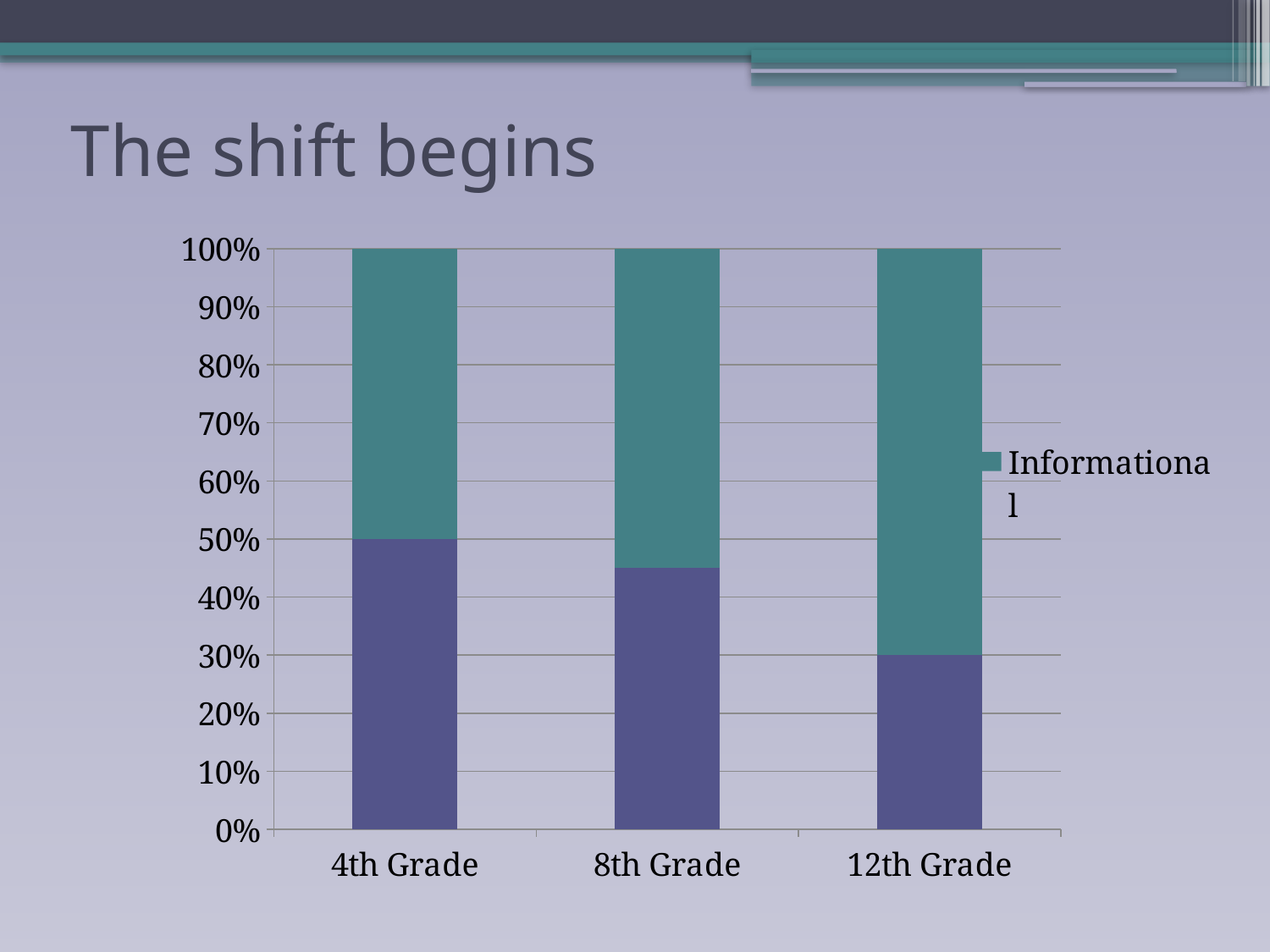
Which grade has the largest Informational (teal) share? 12th Grade What kind of chart is shown on the slide? stacked bar chart Is the purple (bottom) segment for 8th Grade greater or less than 40%? greater Is the purple (bottom) segment for 8th Grade greater or less than 50%? less How many grade categories are shown on the x axis? 3 Is the Informational (teal) share larger for 8th Grade or 12th Grade? 12th Grade What series name is shown in the chart legend? Informational At what percentage does the purple (bottom) segment for 4th Grade end? 50% Which grade has the smallest Informational (teal) share? 4th Grade Does the purple (bottom) segment rise or fall from 4th Grade to 12th Grade? fall At what percentage does the purple (bottom) segment for 12th Grade end? 30% What is the title of the slide containing the chart? The shift begins